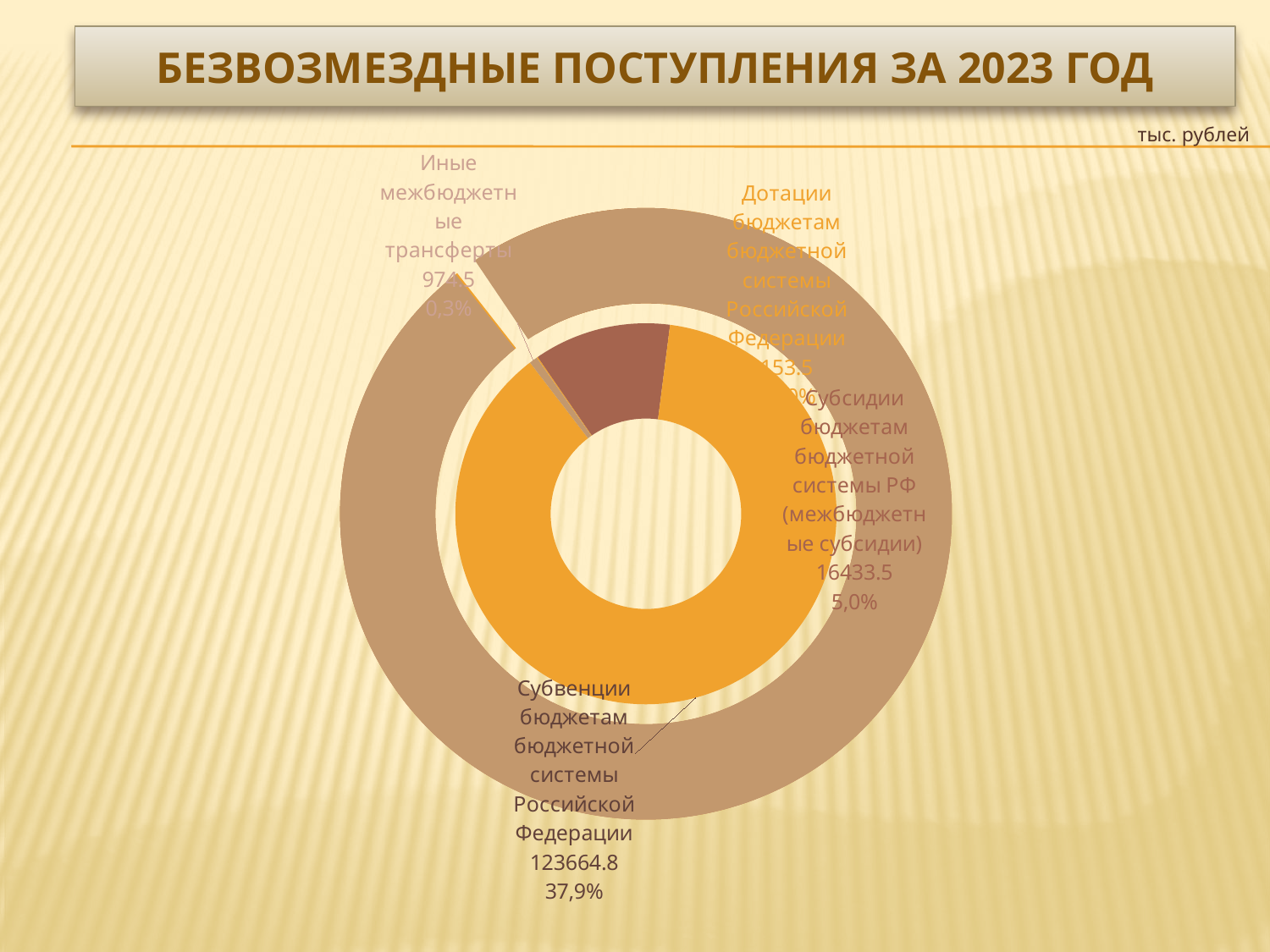
What is the value for Субсидии бюджетам бюджетной системы РФ (межбюджетные субсидии)? 16433.5 What share of the total do Субвенции бюджетам бюджетной системы Российской Федерации make up? 37,9% What kind of chart is shown on the slide? doughnut chart What is the value for Иные межбюджетные трансферты? 974.5 What is the difference between the values for Субвенции (123664.8) and Субсидии (16433.5)? 107231.3 In what units are the chart values given? тыс. рублей What share of the total do Субсидии бюджетам бюджетной системы РФ (межбюджетные субсидии) make up? 5,0% What is the value for Субвенции бюджетам бюджетной системы Российской Федерации? 123664.8 How many categories are shown in the chart? 4 Which is larger: Субвенции бюджетам бюджетной системы Российской Федерации or Субсидии бюджетам бюджетной системы РФ? Субвенции бюджетам бюджетной системы Российской Федерации What share of the total do Иные межбюджетные трансферты make up? 0,3% Which category has the smallest share of the total? Дотации бюджетам бюджетной системы Российской Федерации